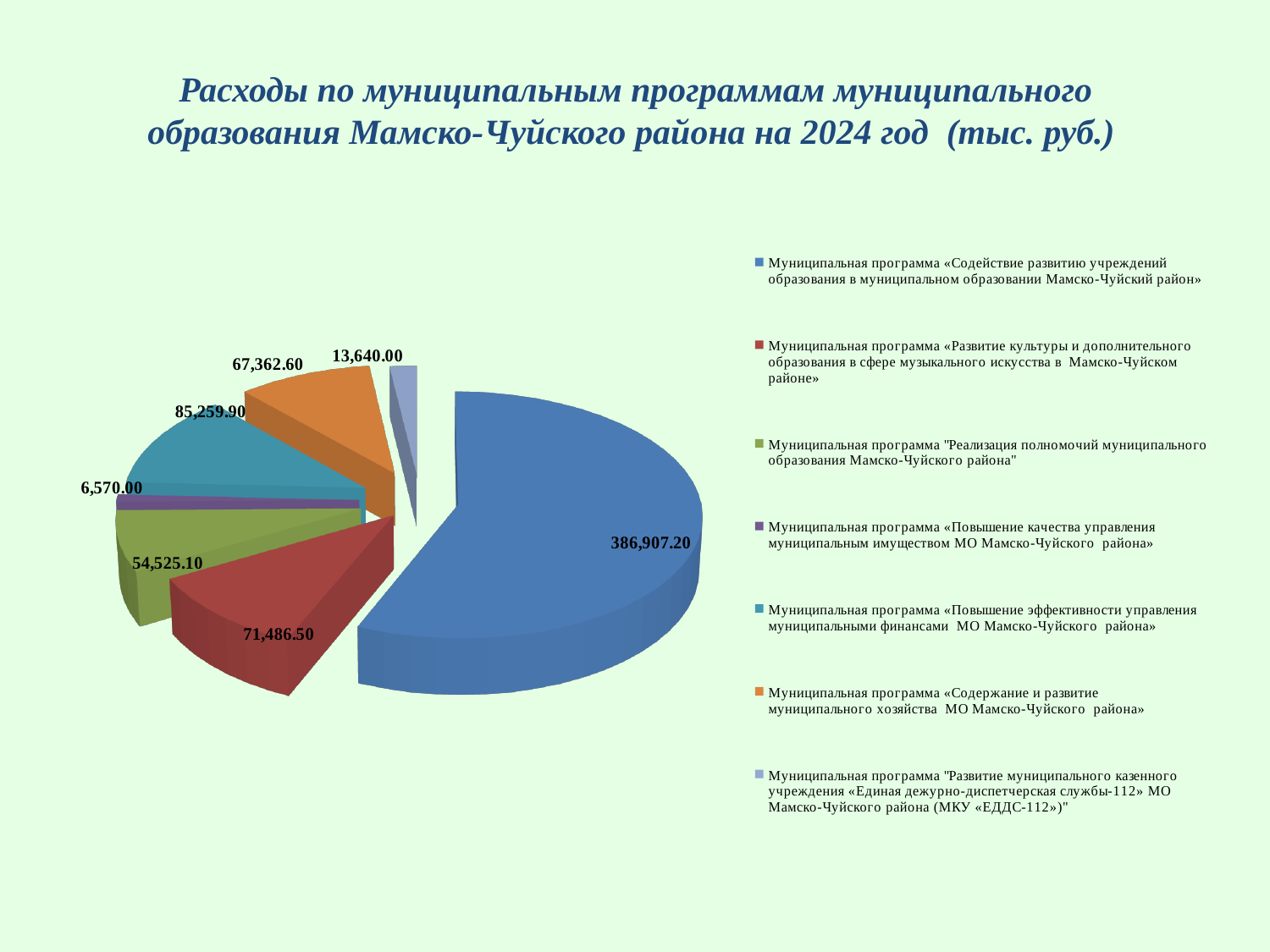
What is the difference between the value for «Повышение эффективности управления муниципальными финансами» (85,259.90) and the value for «Развитие культуры и дополнительного образования в сфере музыкального искусства» (71,486.50)? 13,773.40 Which is larger: the value for «Реализация полномочий муниципального образования Мамско-Чуйского района» or the value for «Содержание и развитие муниципального хозяйства»? «Содержание и развитие муниципального хозяйства» (67,362.60) What is the value for the program «Повышение эффективности управления муниципальными финансами МО Мамско-Чуйского района»? 85,259.90 How many entries does the legend list? 7 What is the value for the program «Повышение качества управления муниципальным имуществом МО Мамско-Чуйского района»? 6,570.00 Which program has the smallest slice of the pie? Муниципальная программа «Повышение качества управления муниципальным имуществом МО Мамско-Чуйского района» What is the value for the program «Содержание и развитие муниципального хозяйства МО Мамско-Чуйского района»? 67,362.60 Which program has the largest slice of the pie? Муниципальная программа «Содействие развитию учреждений образования в муниципальном образовании Мамско-Чуйский район» How many slices does the pie chart have? 7 What kind of chart is shown on the slide? pie chart What is the value for the program «Содействие развитию учреждений образования в муниципальном образовании Мамско-Чуйский район»? 386,907.20 What is the title of the chart on the slide? Расходы по муниципальным программам муниципального образования Мамско-Чуйского района на 2024 год (тыс. руб.)